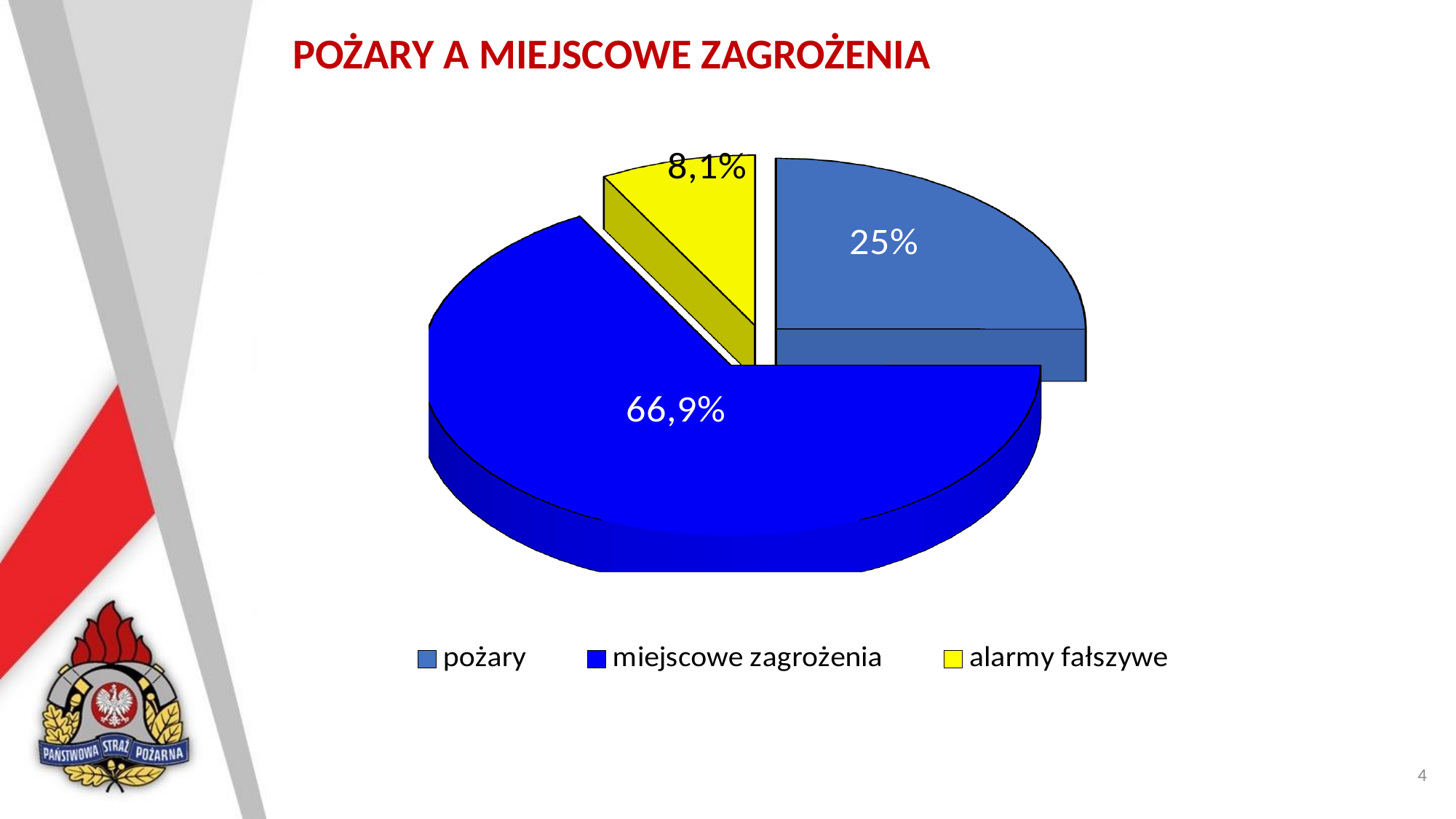
What share of the pie does "alarmy fałszywe" have? 8,1% What is the difference in percentage points between "pożary" and "alarmy fałszywe"? 16,9 Which category has the largest slice of the pie? miejscowe zagrożenia What colour is the slice for "alarmy fałszywe"? yellow What share of the pie does "pożary" have? 25% Which is larger, the slice for "pożary" or the slice for "alarmy fałszywe"? pożary What kind of chart is shown on the slide? pie chart Which category has the smallest slice of the pie? alarmy fałszywe How many categories does the pie chart show? 3 What is the title of the slide above the chart? POŻARY A MIEJSCOWE ZAGROŻENIA What is the difference in percentage points between "miejscowe zagrożenia" and "pożary"? 41,9 What share of the pie does "miejscowe zagrożenia" have? 66,9%